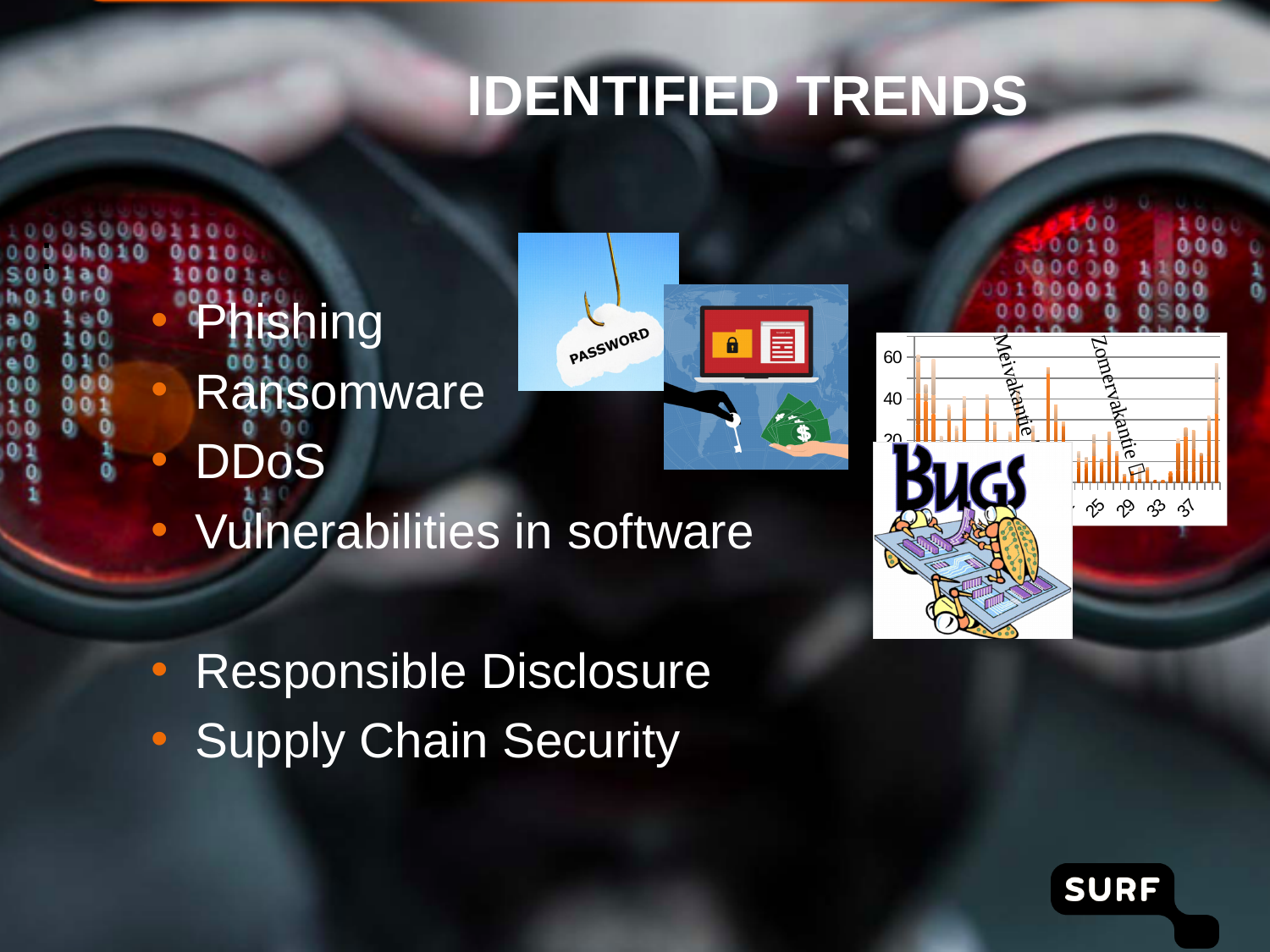
What colour are the bars in the chart on the right side of the slide? orange What are the two annotations written on the chart on the right side of the slide? Meivakantie and Zomervakantie What is the highest value tick shown on the y axis of the chart on the right side of the slide? 60 What kind of chart is shown on the right side of the slide? bar chart